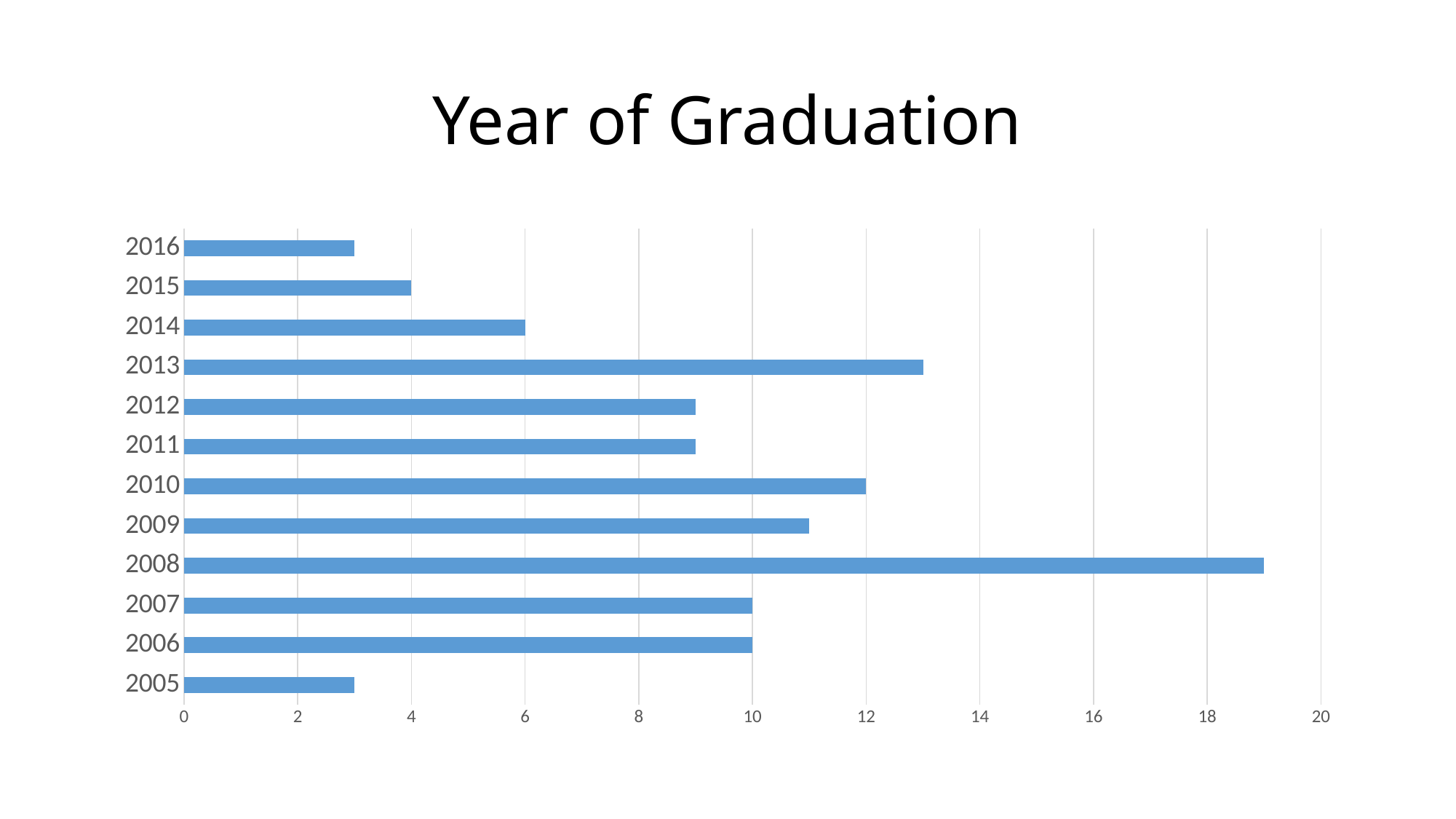
What is the difference between the values for 2010 and 2014? 6 What is the value for 2007? 10 What kind of chart is shown on the slide? bar chart Which is larger, the value for 2013 or the value for 2009? 2013 Is the value for 2016 greater or less than 4? less What is the value for 2010? 12 Is the value for 2008 greater or less than 18? greater What is the value for 2014? 6 Which year has the highest value? 2008 How many years (categories) are plotted in the chart? 12 What is the value for 2015? 4 What is the title of the chart? Year of Graduation